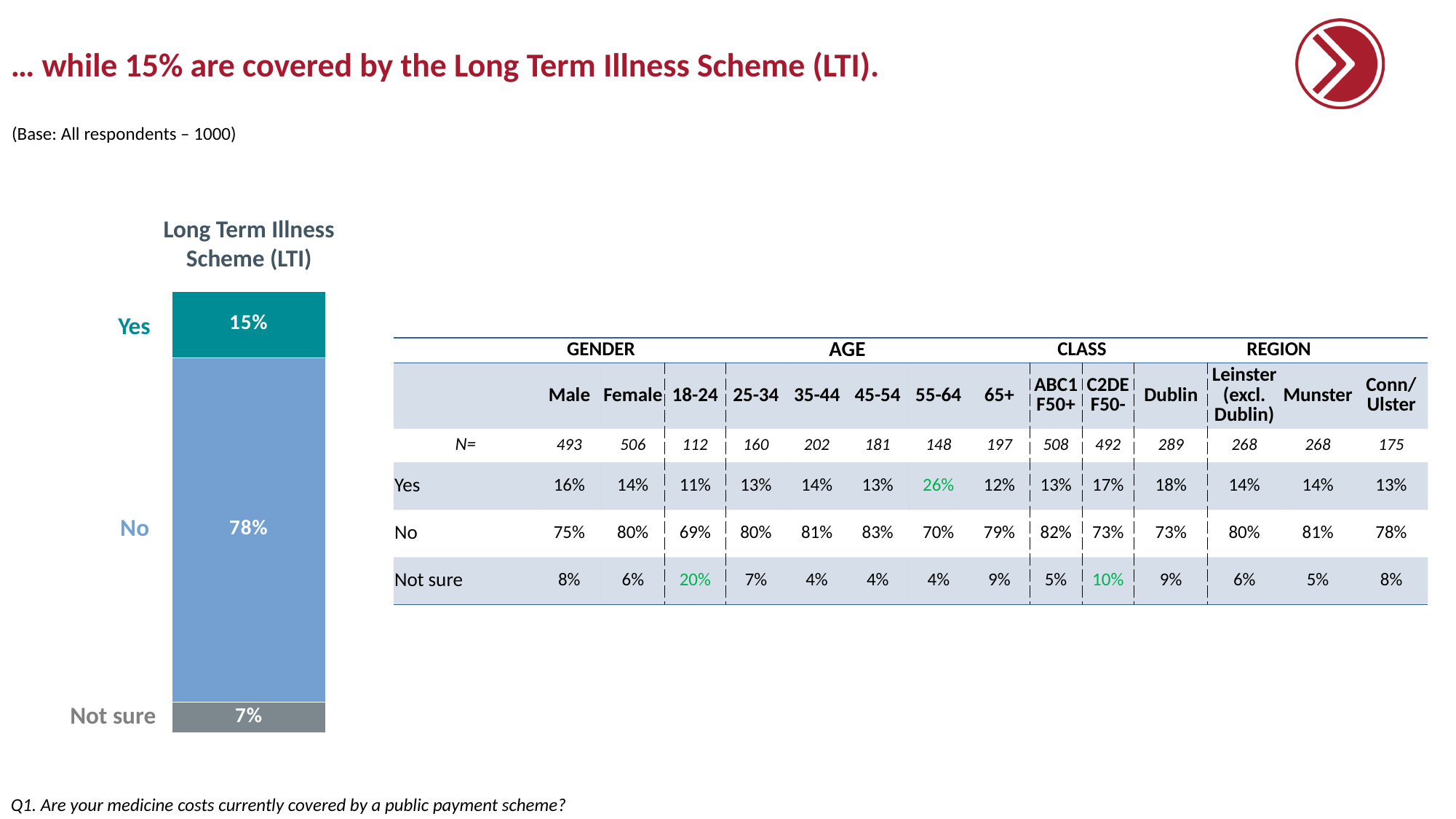
What percentage of respondents answered 'Not sure' in the Long Term Illness Scheme (LTI) chart? 7% What percentage of respondents answered 'Yes' in the Long Term Illness Scheme (LTI) chart? 15% Which response has the smallest segment in the Long Term Illness Scheme (LTI) chart? Not sure What is the total of the three segments in the Long Term Illness Scheme (LTI) stacked bar? 100% Which is larger in the Long Term Illness Scheme (LTI) chart, 'Yes' or 'Not sure'? Yes How many response categories are shown in the Long Term Illness Scheme (LTI) chart? 3 What type of chart is used to show the Long Term Illness Scheme (LTI) results? Stacked bar chart What is the difference between the 'No' and 'Yes' percentages in the Long Term Illness Scheme (LTI) chart? 63 percentage points What percentage of respondents answered 'No' in the Long Term Illness Scheme (LTI) chart? 78% Which response has the largest segment in the Long Term Illness Scheme (LTI) chart? No What is the difference between the 'Yes' and 'Not sure' percentages in the Long Term Illness Scheme (LTI) chart? 8 percentage points What is the title of the stacked bar chart on the slide? Long Term Illness Scheme (LTI)